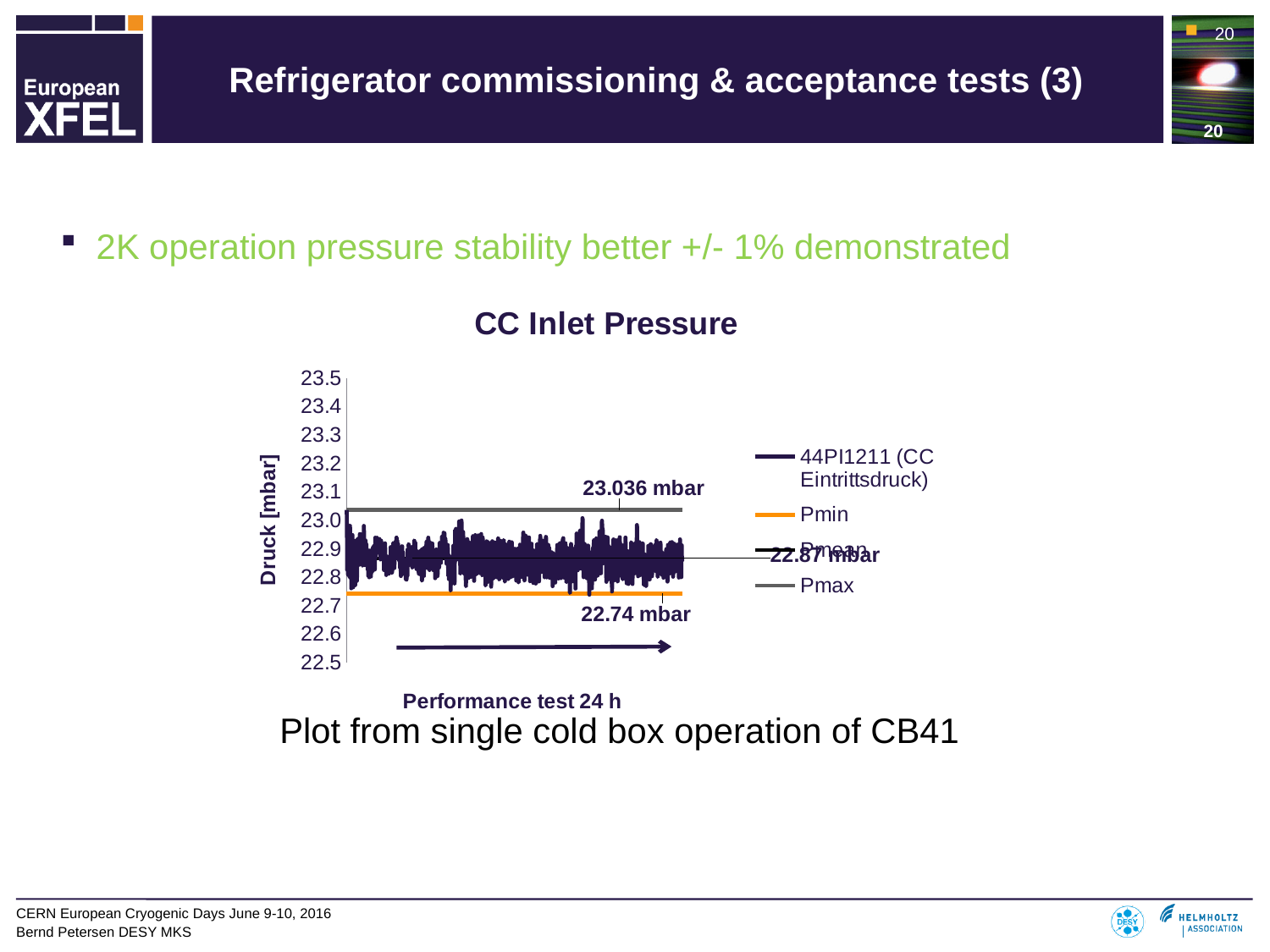
What kind of chart is shown under the title "CC Inlet Pressure"? line chart What value is labelled for Pmax in the CC Inlet Pressure chart? 23.036 mbar What value is labelled for Pmin in the CC Inlet Pressure chart? 22.74 mbar What is the label on the vertical axis of the CC Inlet Pressure chart? Druck [mbar] What is the difference between the labelled Pmax and Pmin values in the CC Inlet Pressure chart? 0.296 mbar Is the Pmin value in the CC Inlet Pressure chart greater or less than 22.8? less Is the Pmax value in the CC Inlet Pressure chart greater or less than 23.0? greater What value is labelled for Pmean in the CC Inlet Pressure chart? 22.87 mbar Which of the labelled lines, Pmax or Pmin, has the larger value in the CC Inlet Pressure chart? Pmax What colour is the Pmin line in the CC Inlet Pressure chart? orange How many series does the legend of the CC Inlet Pressure chart list? 4 What is the difference between the labelled Pmean and Pmin values in the CC Inlet Pressure chart? 0.13 mbar